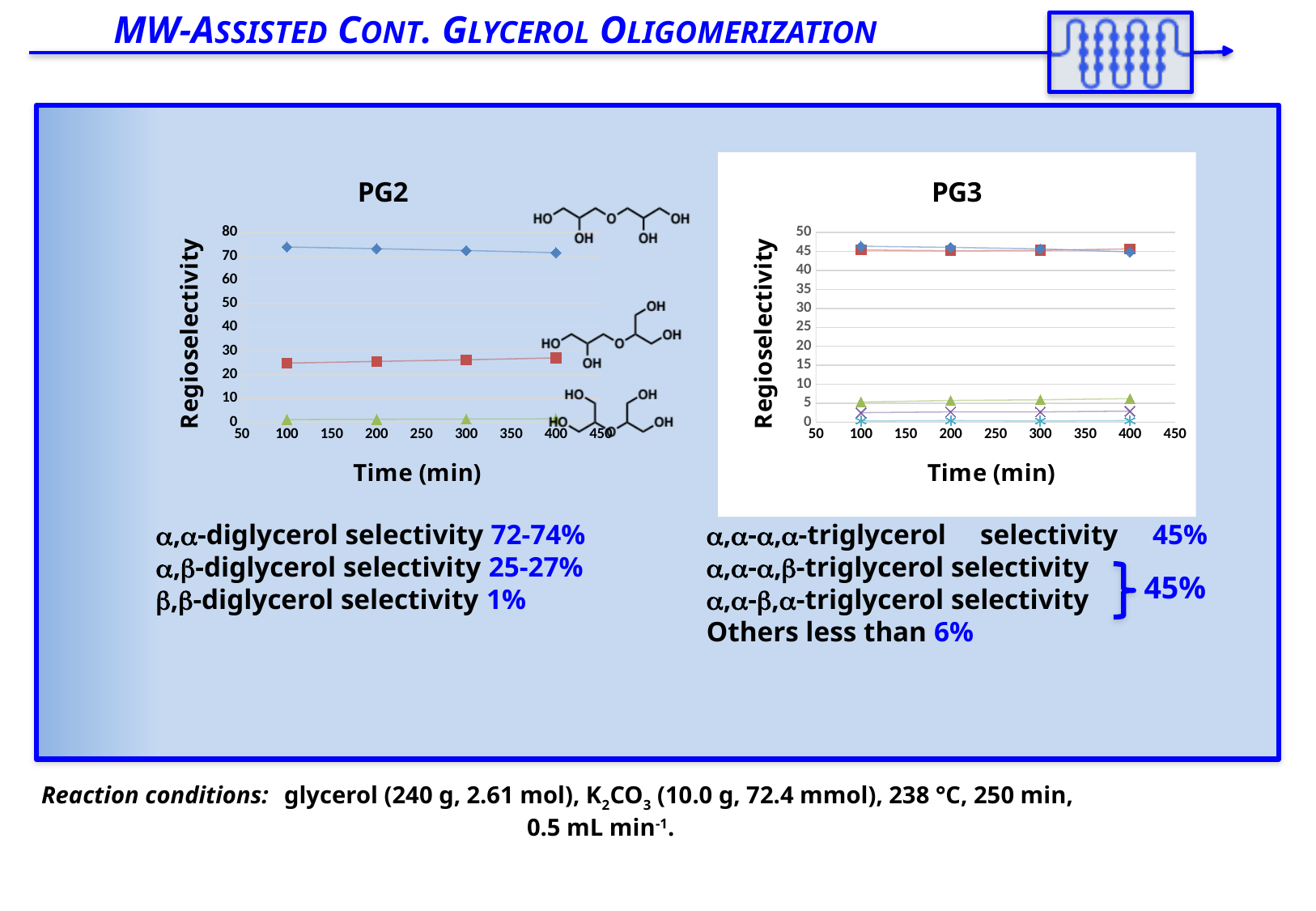
In the PG2 chart, does the red square series rise or fall from 100 min to 400 min? rise In the PG3 chart, is the value of the blue diamond series at 100 min greater or less than 40? greater In the PG2 chart, how many data points does the blue diamond series have? 4 In the PG2 chart, is the value of the green triangle series at 200 min greater or less than 10? less What kind of chart is the PG3 chart? line chart What kind of chart is the PG2 chart? line chart In the PG3 chart, is the value of the green triangle series at 300 min greater or less than 10? less In the PG2 chart, does the blue diamond series rise or fall from 100 min to 400 min? fall In the PG2 chart, which series has the highest values: the blue diamond, red square, or green triangle series? blue diamond series What is the y-axis label of the PG3 chart? Regioselectivity